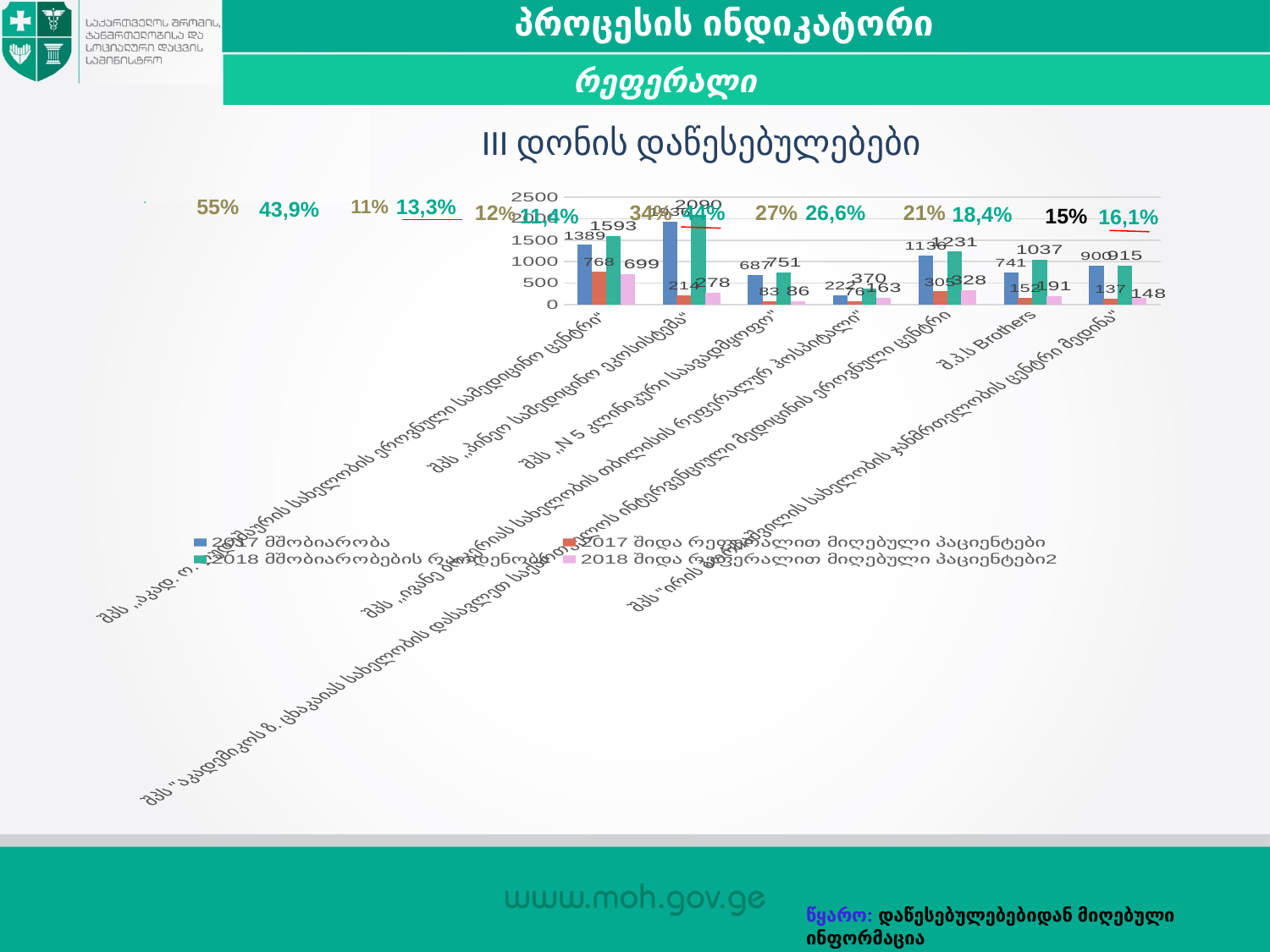
What is the title of the chart? III დონის დაწესებულებები What is the difference between the 2018 მშობიარობების რაოდენობა and 2017 მშობიარობა values for შ.პ.ს Brothers? 296 What kind of chart is shown on the slide? bar chart Is the 2018 მშობიარობების რაოდენობა value for შ.პ.ს Brothers greater or less than 1000? greater What is the value of 2018 მშობიარობების რაოდენობა for შ.პ.ს Brothers? 1037 What is the value of 2017 მშობიარობა for შ.პ.ს Brothers? 741 For შ.პ.ს Brothers, which is larger: 2017 შიდა რეფერალით მიღებული პაციენტები or 2018 შიდა რეფერალით მიღებული პაციენტები2? 2018 შიდა რეფერალით მიღებული პაციენტები2 What is the value of 2018 მშობიარობების რაოდენობა for შპს „N 5 კლინიკური საავადმყოფო"? 751 Which institution has the lowest value for 2017 მშობიარობა? შპს „ივანე ბოკერიას სახელობის თბილისის რეფერალური ჰოსპიტალი" How many institutions (categories) are shown on the x axis of the chart? 7 Which institution has the highest value for 2018 მშობიარობების რაოდენობა? შპს „პინეო სამედიცინო ეკოსისტემა" How many series does the chart legend list? 4